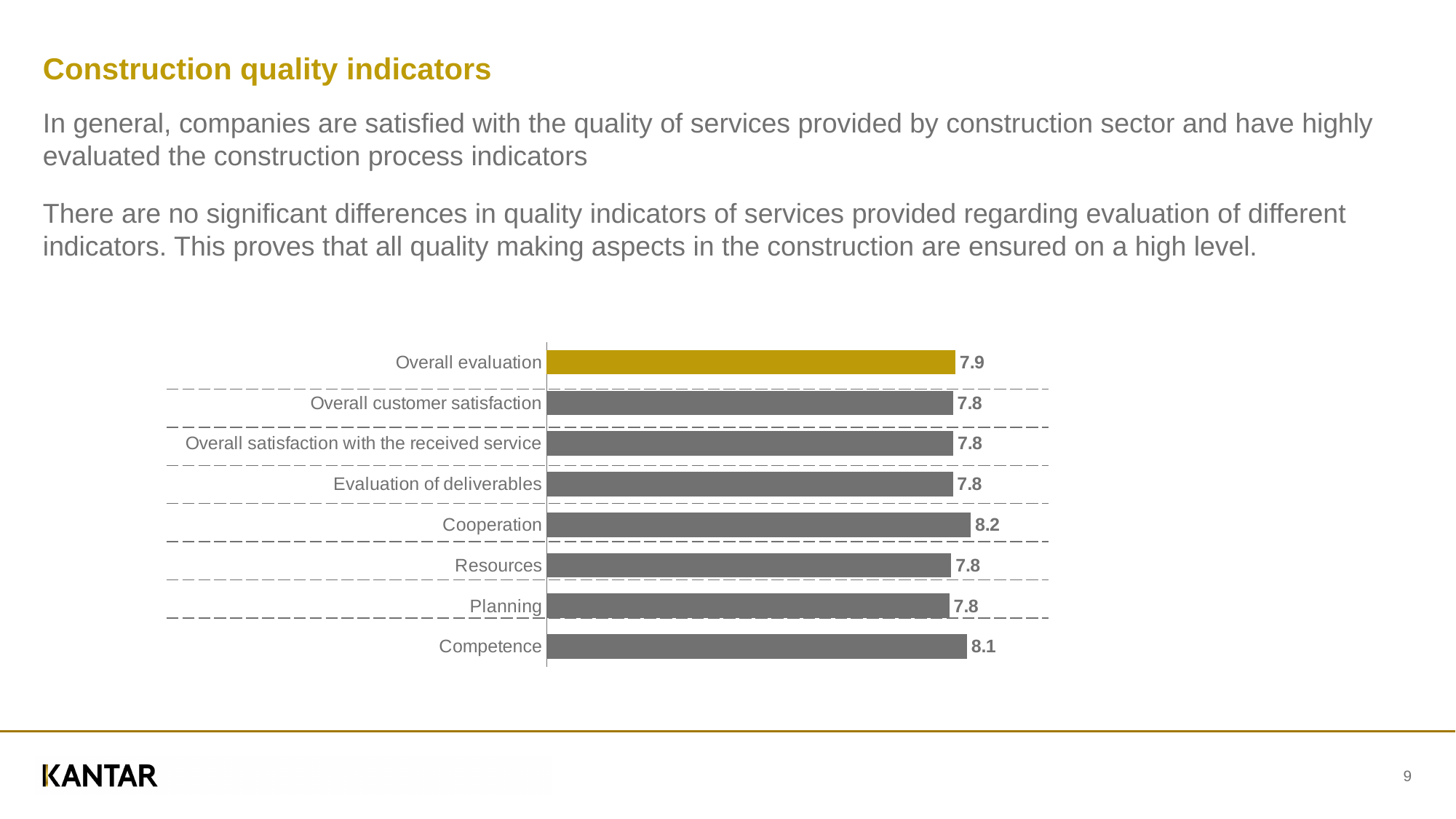
What kind of chart is shown on the slide? Bar chart What is the difference between the values for Cooperation and Resources? 0.4 What is the value for Planning? 7.8 What is the difference between the values for Competence and Overall evaluation? 0.2 How many categories are shown in the chart? 8 What is the value for Overall evaluation? 7.9 Which bar is shown in a different colour (gold) from the others? Overall evaluation Which is larger, the value for Overall evaluation or the value for Evaluation of deliverables? Overall evaluation What is the value for Cooperation? 8.2 Which is larger, the value for Cooperation or the value for Competence? Cooperation What is the value for Competence? 8.1 Which category has the highest value? Cooperation